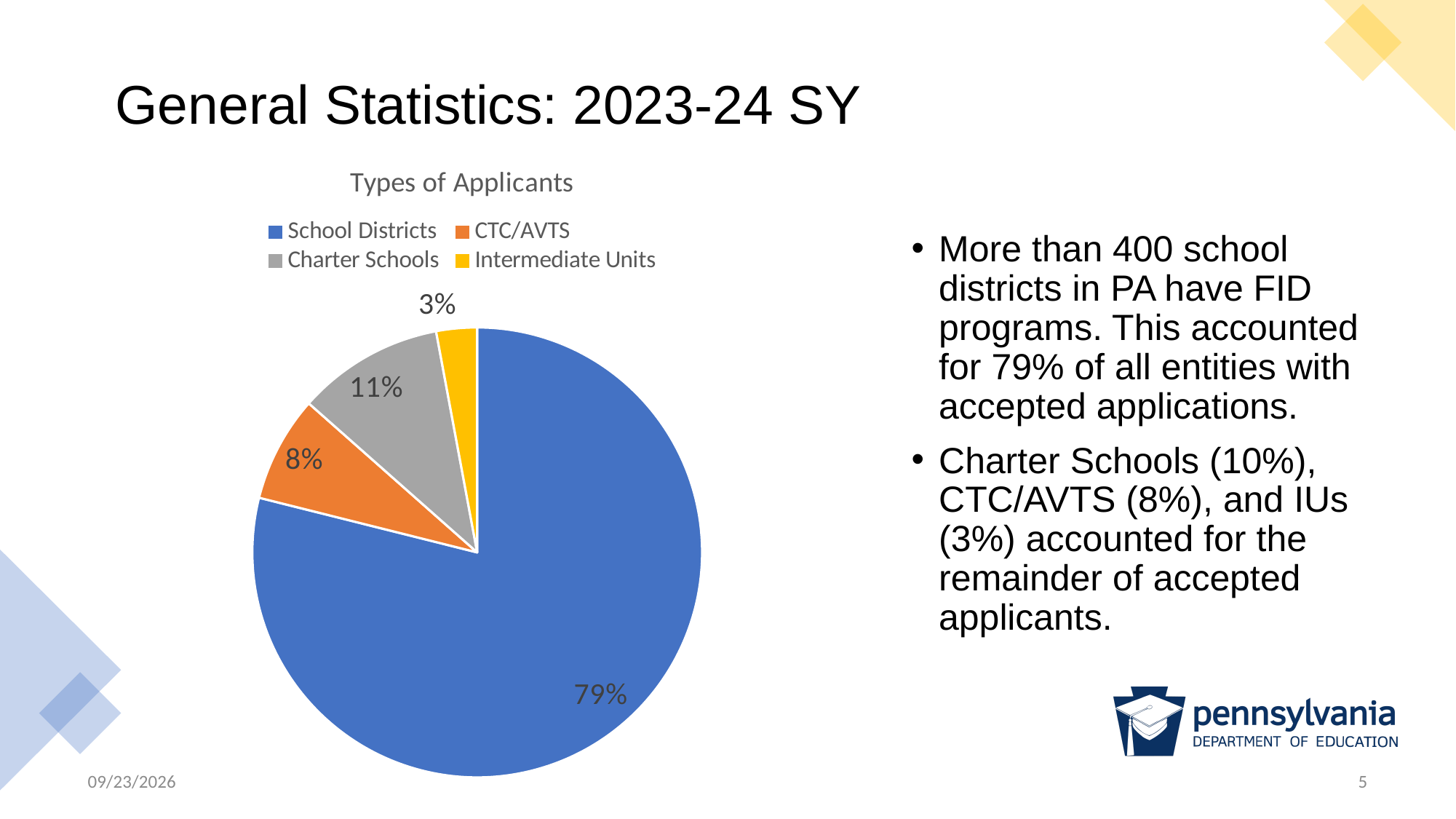
What share of the pie do School Districts account for? 79% What type of chart is shown on the slide? Pie chart Which is larger, the Charter Schools slice or the CTC/AVTS slice? Charter Schools What share of the pie do Intermediate Units account for? 3% What is the title of the chart? Types of Applicants What is the difference in percentage points between the School Districts slice and the Charter Schools slice? 68 What share of the pie does CTC/AVTS account for? 8% What colour is the Intermediate Units slice? Yellow How many categories does the pie chart show? 4 Which category has the largest slice of the pie? School Districts Which category has the smallest slice of the pie? Intermediate Units